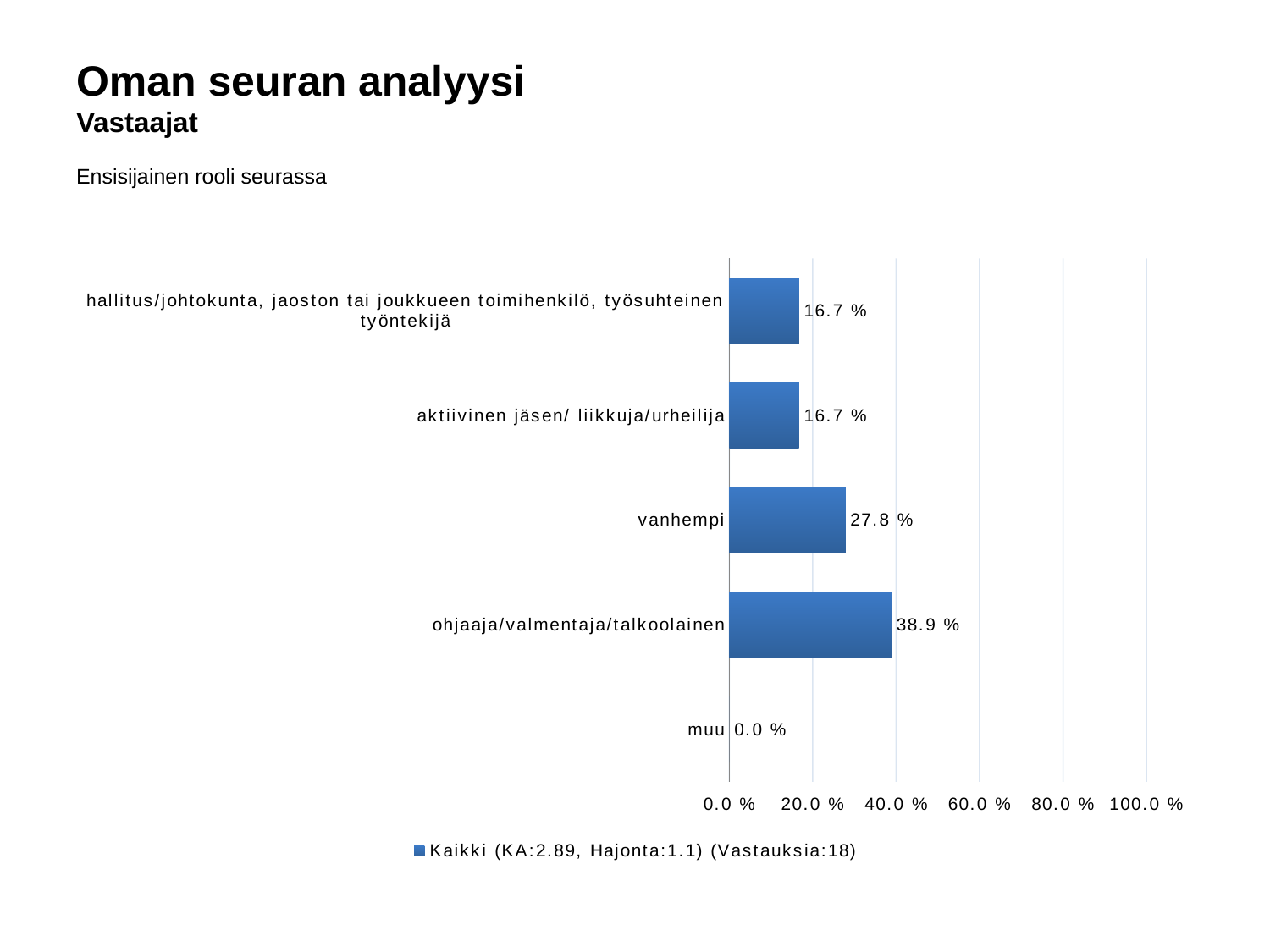
What is the legend entry of the chart? Kaikki (KA:2.89, Hajonta:1.1) (Vastauksia:18) What is the value for "muu"? 0.0 % What is the difference between the values for "ohjaaja/valmentaja/talkoolainen" and "vanhempi"? 11.1 % What is the value for "ohjaaja/valmentaja/talkoolainen"? 38.9 % Which category has the highest value? ohjaaja/valmentaja/talkoolainen How many categories are shown in the chart? 5 What kind of chart is shown on the slide? bar chart Which is larger, the value for "vanhempi" or the value for "aktiivinen jäsen/ liikkuja/urheilija"? vanhempi What is the value for "vanhempi"? 27.8 % Is the value for "ohjaaja/valmentaja/talkoolainen" greater or less than 40.0 %? less Which category has the lowest value? muu What is the value for "aktiivinen jäsen/ liikkuja/urheilija"? 16.7 %